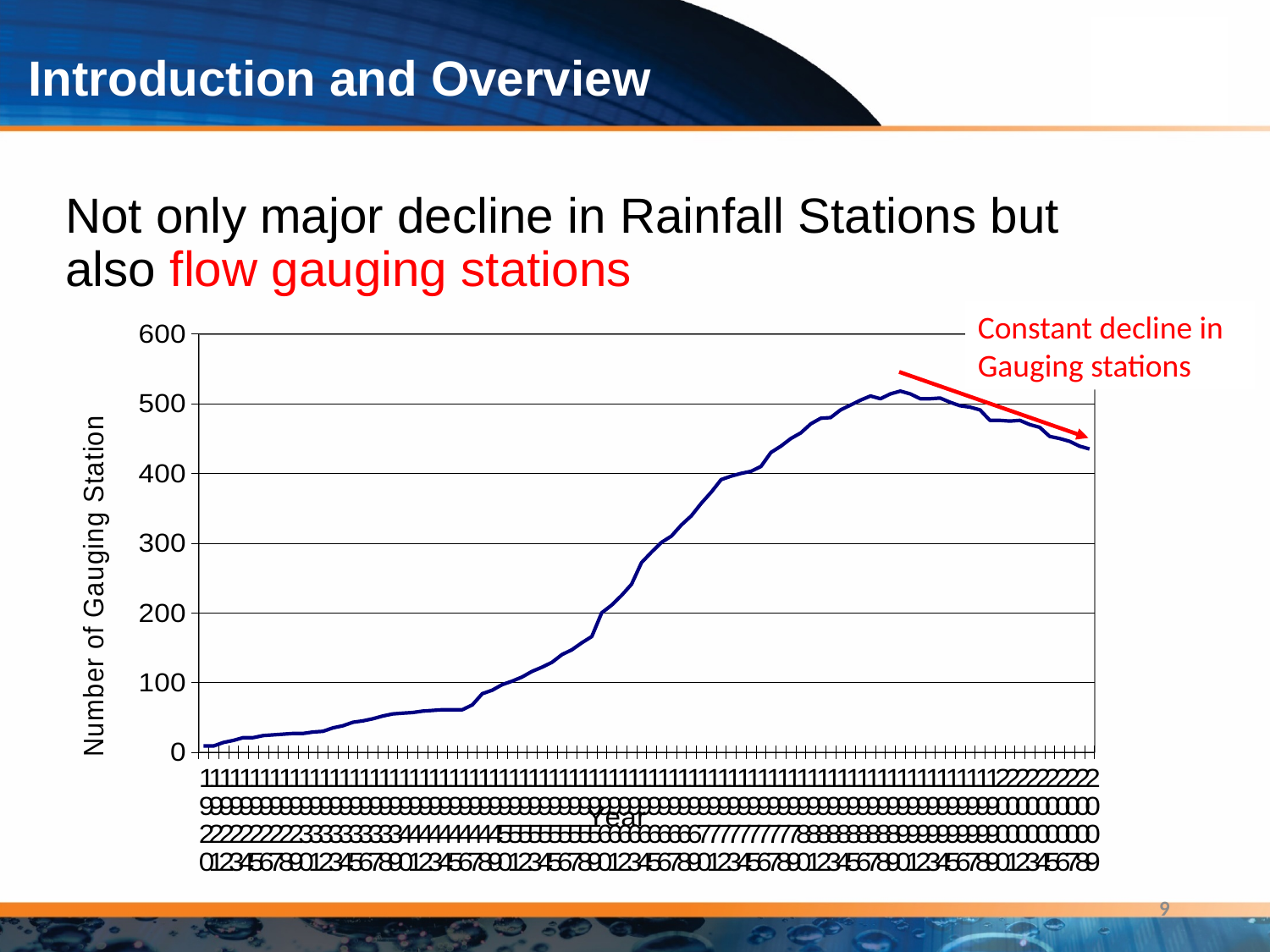
Does the number of gauging stations rise or fall from 1920 to 1990? rise What is the title of the vertical axis of the chart? Number of Gauging Station Is the number of gauging stations in 1980 greater or less than 400? greater What kind of chart is shown on the slide? line chart Does the number of gauging stations rise or fall over the last years of the chart, from about 1991 to 2009? fall What is the title of the horizontal axis of the chart? Year Is the number of gauging stations in 1970 greater or less than 300? greater Is the number of gauging stations in 2009 greater or less than 500? less Which year has more gauging stations, 1950 or 1990? 1990